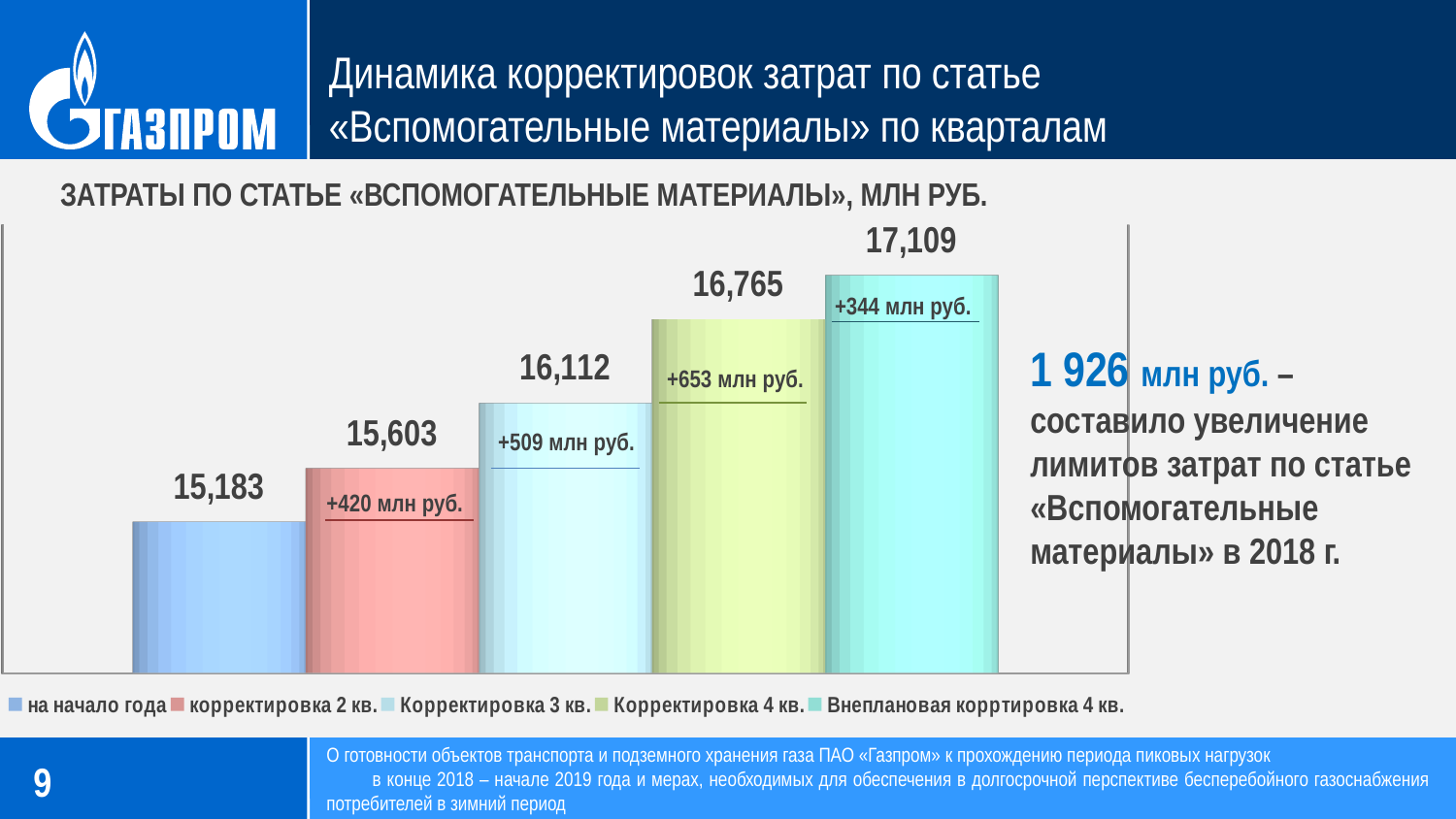
How many bars are plotted in the chart? 5 What is the value for «Корректировка 3 кв.»? 16,112 Which is larger, the value for «Корректировка 4 кв.» or the value for «корректировка 2 кв.»? Корректировка 4 кв. What is the value for «Внеплановая корртировка 4 кв.»? 17,109 How many entries does the legend list? 5 What kind of chart is shown on the slide? bar chart What is the value for «на начало года»? 15,183 Which category has the lowest value? на начало года What is the difference between the values for «корректировка 2 кв.» and «на начало года»? 420 Do the values rise or fall from left to right across the bars? rise Which category has the highest value? Внеплановая корртировка 4 кв. What is the difference between the values for «Корректировка 4 кв.» and «Корректировка 3 кв.»? 653